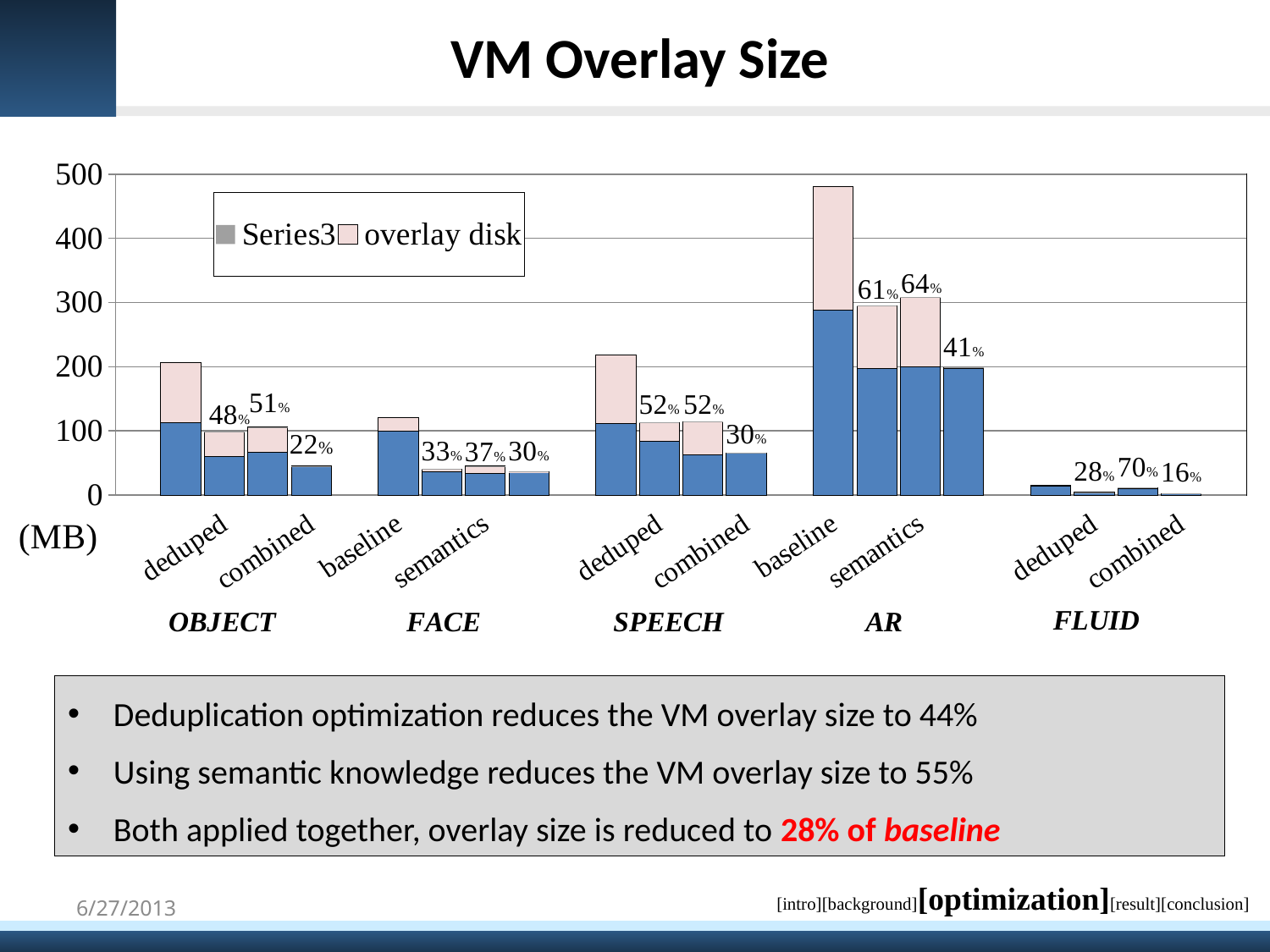
What kind of chart is shown on the slide? bar chart Is the value for the FACE baseline bar greater or less than 200? less Which is larger, the SPEECH baseline bar or the FACE baseline bar? SPEECH baseline Which application group has the tallest baseline bar? AR Is the value for the AR baseline bar greater or less than 400? greater What are the two entries in the chart legend? Series3 and overlay disk What percentage label is shown on the combined bar in the OBJECT group? 22% What percentage label is shown on the semantics bar in the FLUID group? 70% How many application groups (OBJECT, FACE, etc.) are shown along the x axis? 5 Which application group has the shortest baseline bar? FLUID How many series does the chart legend list? 2 What percentage label is shown on the semantics bar in the AR group? 64%